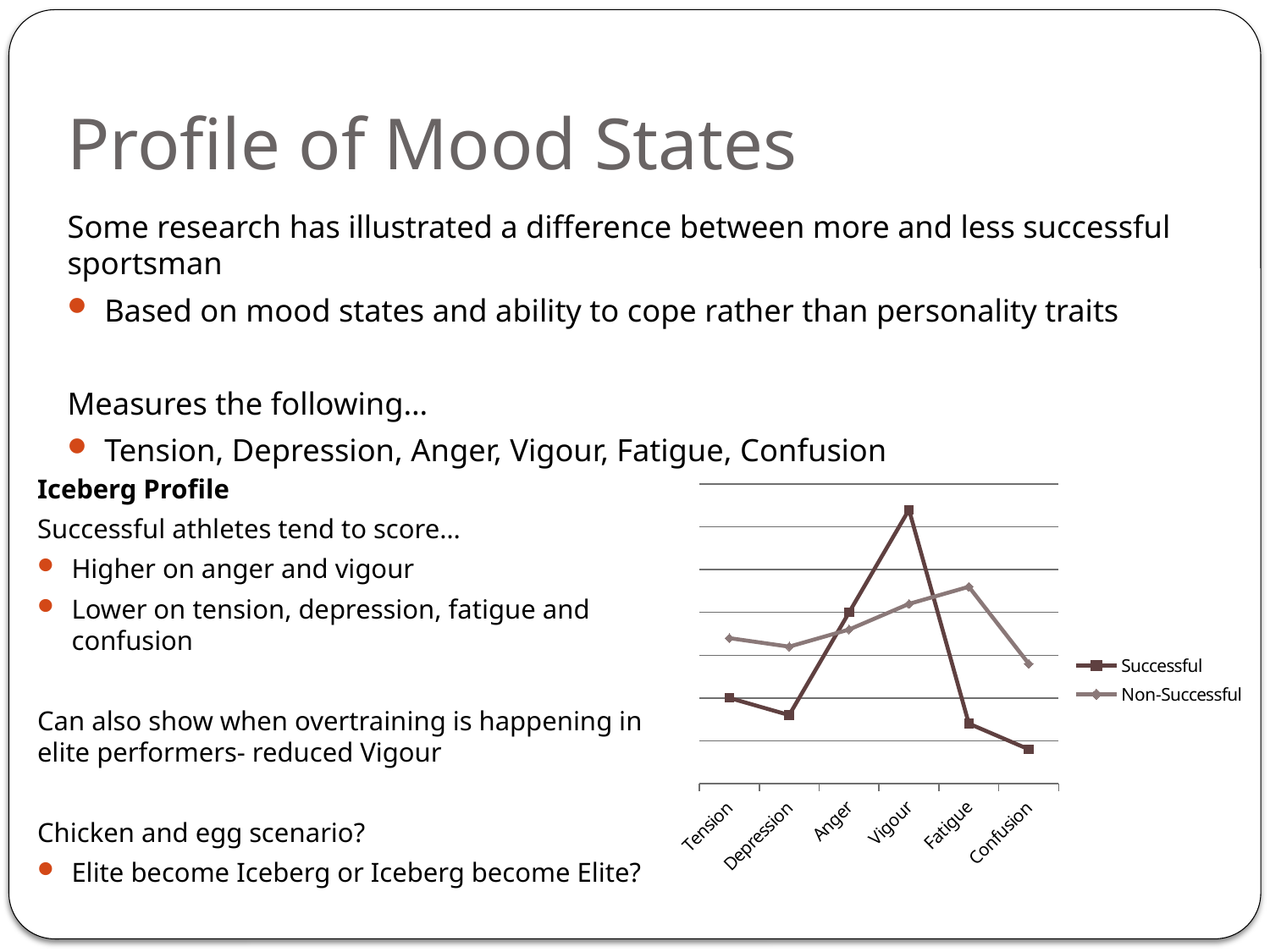
How many series does the chart legend list? 2 What kind of chart is shown on the slide? line chart Which category has the lowest value for the Non-Successful series? Confusion Does the Successful series rise or fall from Vigour to Confusion? fall Which category has the highest value for the Non-Successful series? Fatigue How many mood state categories are plotted along the x axis of the chart? 6 What are the two series named in the chart legend? Successful and Non-Successful Which category has the lowest value for the Successful series? Confusion At Fatigue, which series has the larger value, Successful or Non-Successful? Non-Successful At Vigour, which series has the larger value, Successful or Non-Successful? Successful At Tension, which series has the larger value, Successful or Non-Successful? Non-Successful Which category has the highest value for the Successful series? Vigour